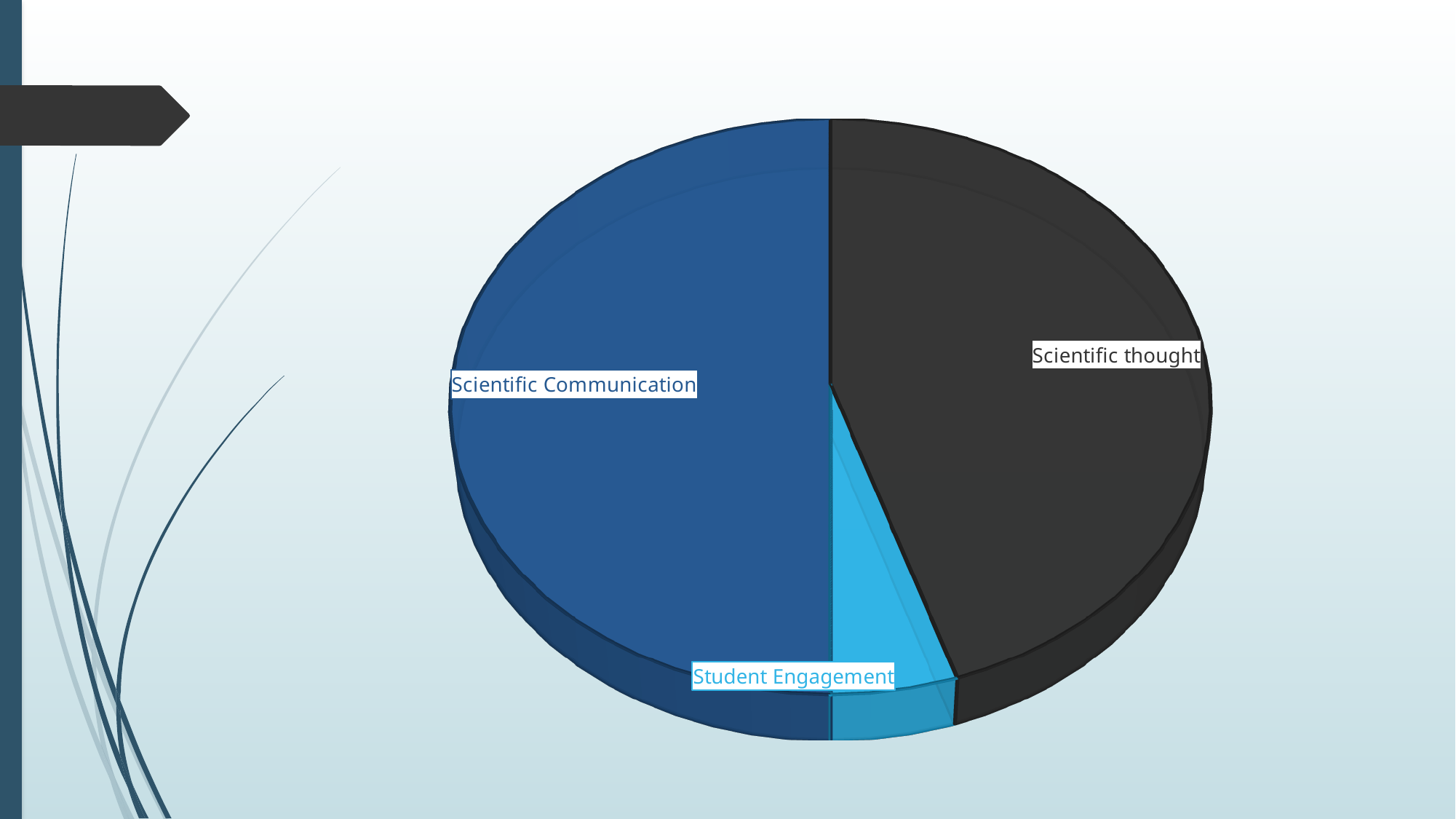
Which slice is larger, Scientific Communication or Scientific thought? Scientific Communication Does the Scientific Communication slice take up more or less than a quarter of the pie? more What kind of chart is shown on the slide? Pie chart How many slices does the pie chart have? 3 What colour is the Student Engagement slice? Light blue What colour is the Scientific thought slice? Dark grey Which slice of the pie chart is the smallest? Student Engagement Which slice is larger, Scientific thought or Student Engagement? Scientific thought Which slice is larger, Scientific Communication or Student Engagement? Scientific Communication Does the Student Engagement slice take up more or less than a quarter of the pie? less Which slice of the pie chart is the largest? Scientific Communication